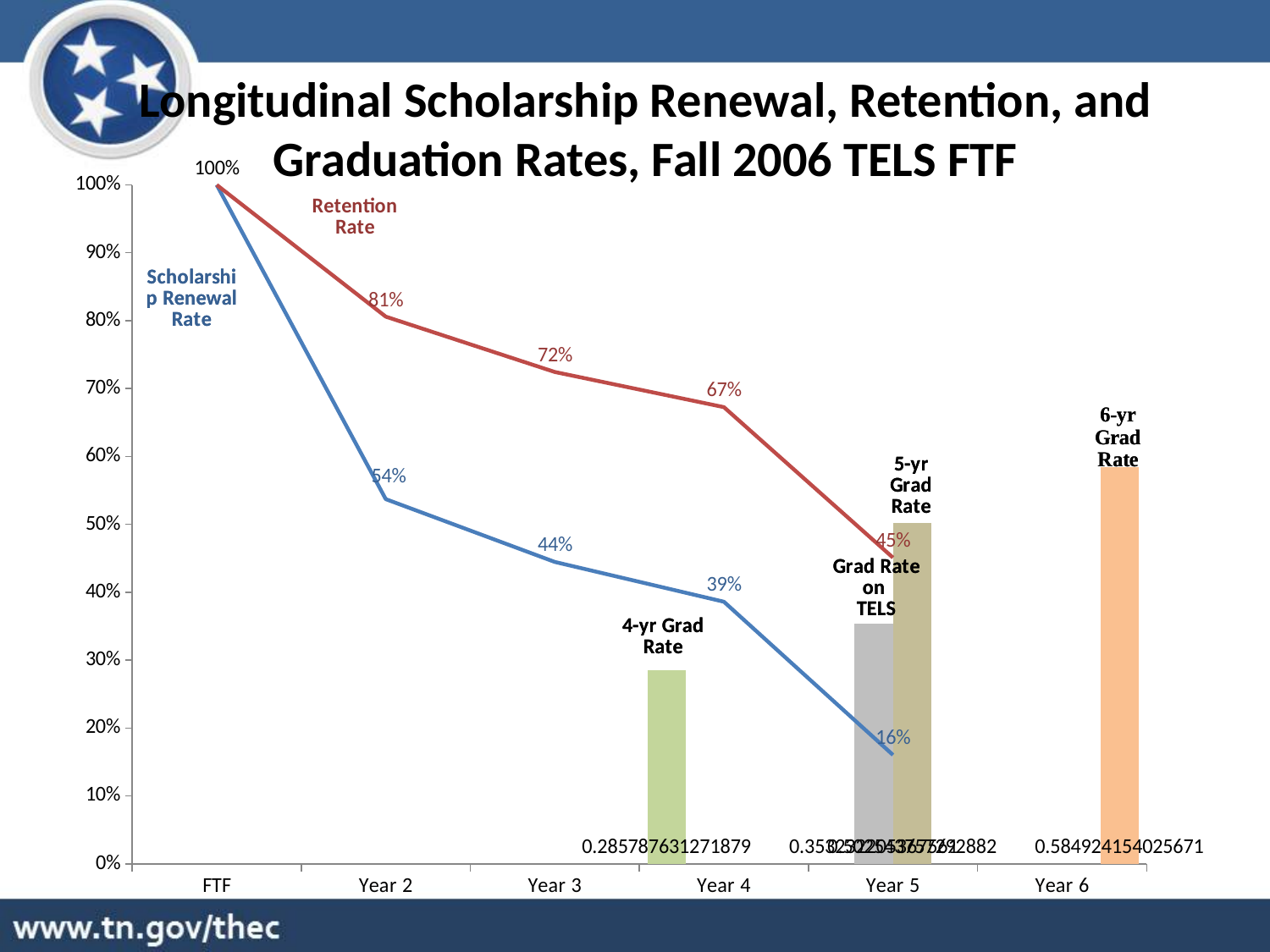
What is the Retention Rate at Year 5? 45% What is the data label shown on the 4-yr Grad Rate bar? 0.285787631271879 Which is larger at Year 4, the Retention Rate or the Scholarship Renewal Rate? Retention Rate Does the Scholarship Renewal Rate rise or fall from FTF to Year 5? fall What is the title of the chart? Longitudinal Scholarship Renewal, Retention, and Graduation Rates, Fall 2006 TELS FTF How many categories are shown on the x axis? 6 What is the Scholarship Renewal Rate at Year 5? 16% What is the Retention Rate at Year 2? 81% What is the Scholarship Renewal Rate at Year 4? 39% What is the data label shown on the 6-yr Grad Rate bar? 0.584924154025671 What is the difference between the Retention Rate and the Scholarship Renewal Rate at Year 3? 28% Is the 5-yr Grad Rate bar greater or less than 40%? greater